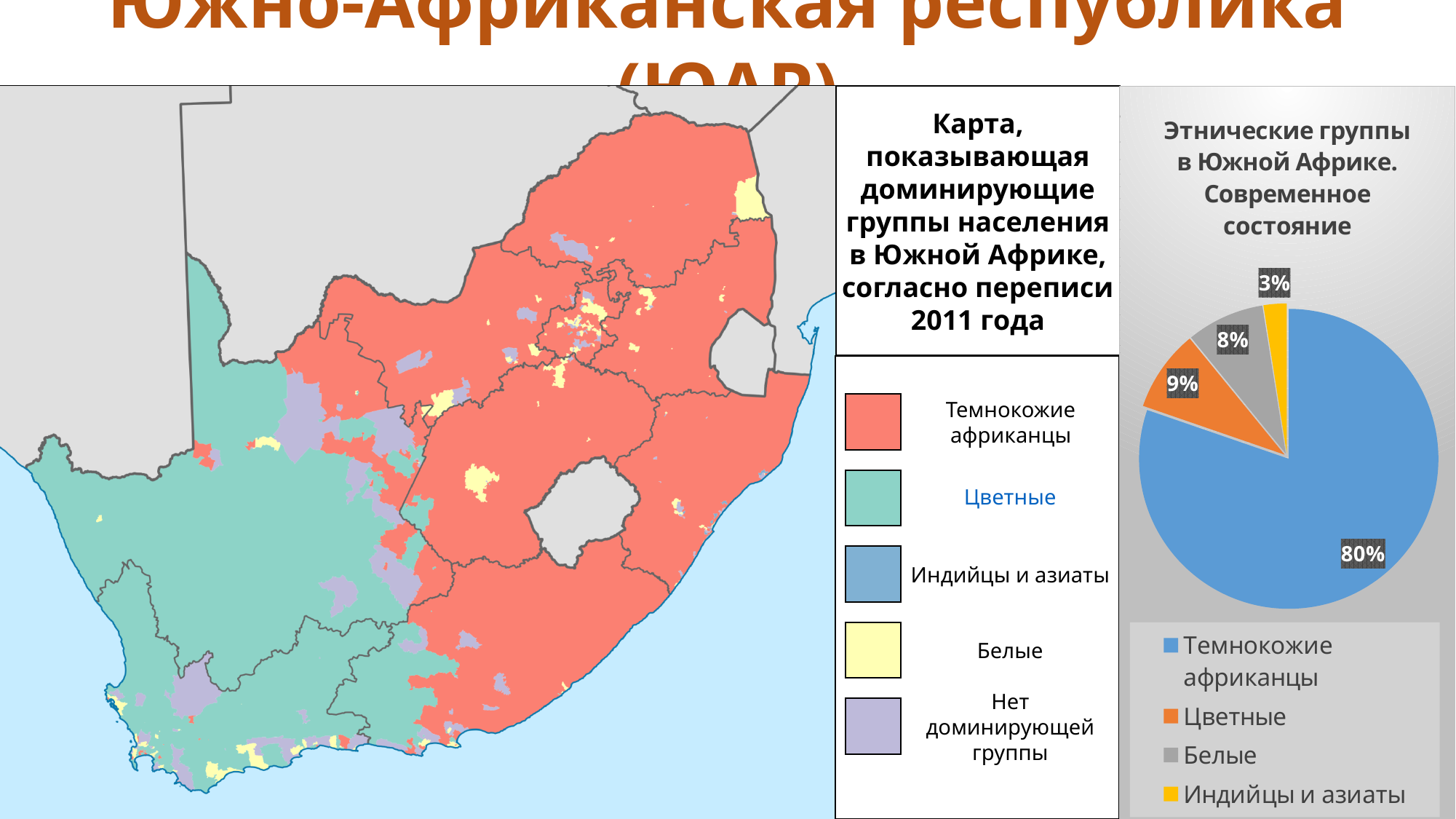
How many slices does the pie chart have? 4 In the pie chart, what share is shown for Цветные? 9% How many entries does the pie chart's legend list? 4 In the pie chart, what share is shown for Темнокожие африканцы? 80% In the pie chart, what is the difference in percentage points between Темнокожие африканцы and Цветные? 71 What is the title of the pie chart? Этнические группы в Южной Африке. Современное состояние In the pie chart, what is the difference in percentage points between Белые and Индийцы и азиаты? 5 What kind of chart is shown on the right side of the slide? Pie chart In the pie chart, what share is shown for Индийцы и азиаты? 3% Which ethnic group has the largest slice in the pie chart? Темнокожие африканцы Which ethnic group has the smallest slice in the pie chart? Индийцы и азиаты In the pie chart, what share is shown for Белые? 8%